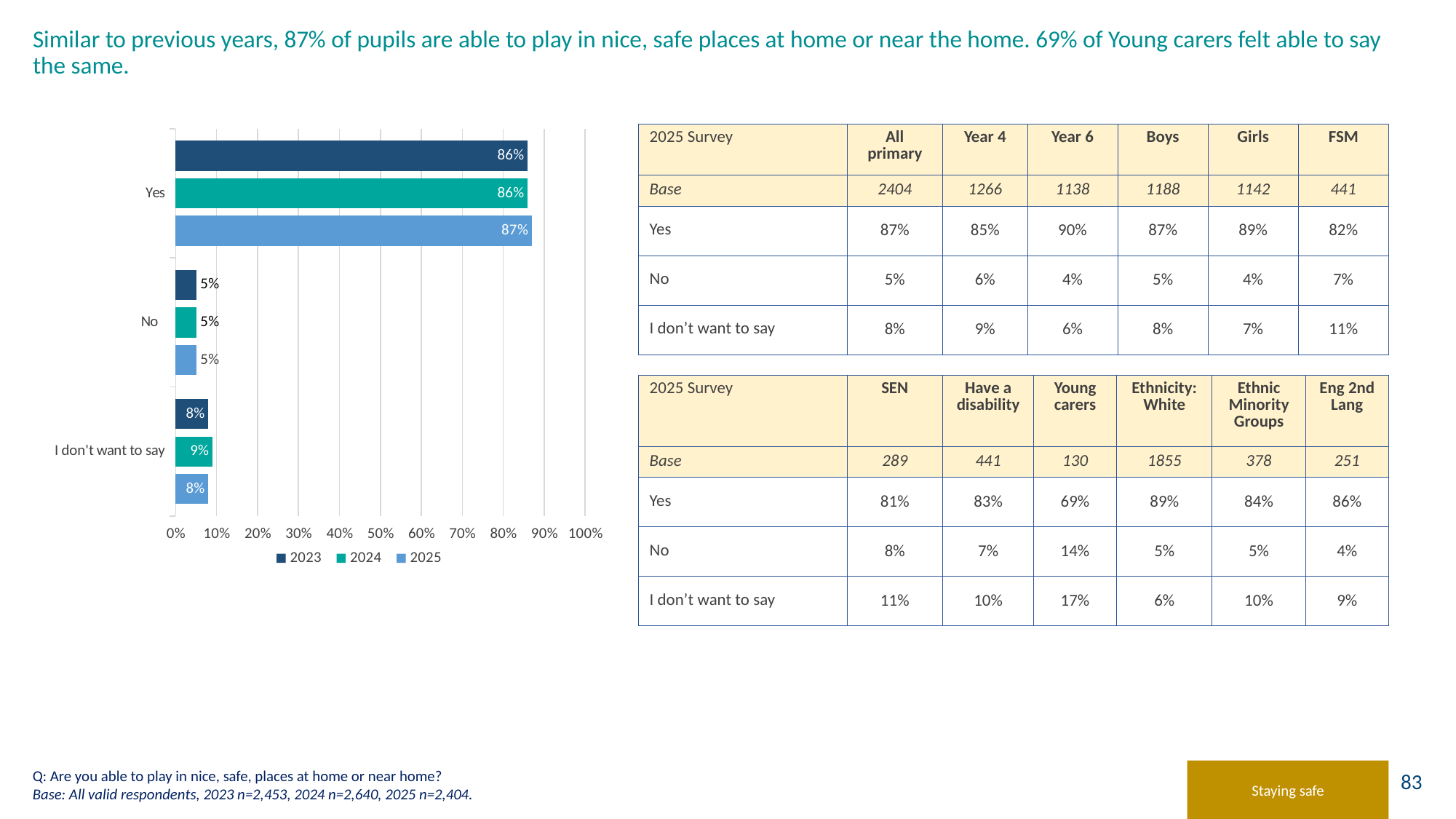
Which series is shown in the darkest blue colour in the legend? 2023 Which is larger: the 'I don't want to say' value in 2024 or in 2025? 2024 Which response category has the lowest value in 2023? No What is the value for 'Yes' in 2025? 87% What is the value for 'I don't want to say' in 2024? 9% What is the value for 'No' in 2024? 5% What kind of chart is shown on the slide? bar chart How many response categories are shown on the chart's y axis? 3 Which response category has the highest value in 2025? Yes What is the difference between the 'Yes' value in 2025 and the 'Yes' value in 2024? 1% What is the value for 'Yes' in 2023? 86% How many series does the chart legend list? 3